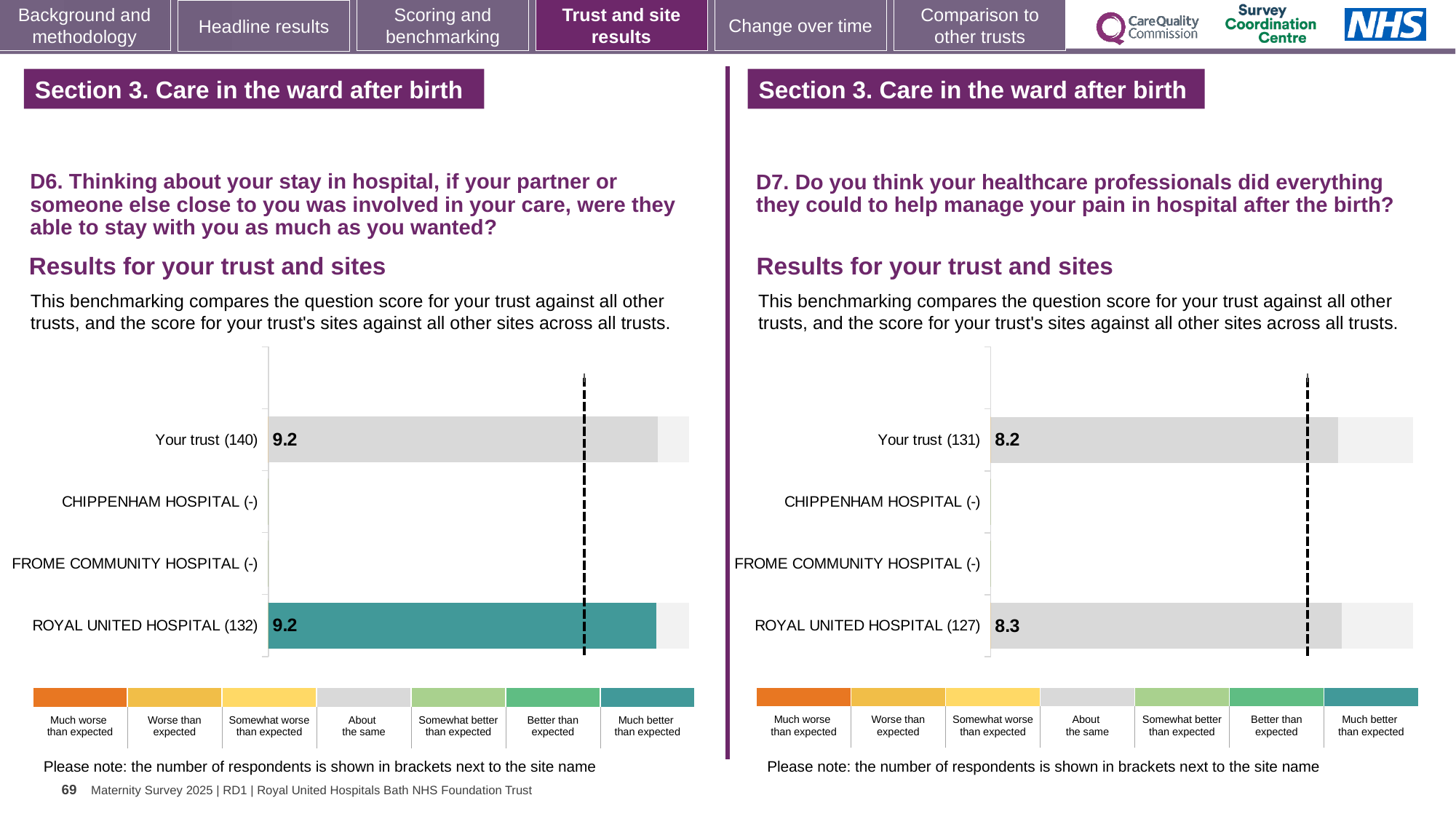
In the D6 chart on the left, what is the score for ROYAL UNITED HOSPITAL? 9.2 In the D6 chart on the left, how many respondents are shown in brackets for ROYAL UNITED HOSPITAL? 132 How many benchmark categories does the colour legend below the D6 chart on the left show? 7 In the D7 chart on the right, what is the difference between the scores for ROYAL UNITED HOSPITAL and Your trust? 0.1 In the D7 chart on the right, what is the score for ROYAL UNITED HOSPITAL? 8.3 What kind of chart is the D7 chart on the right? Bar chart In the D6 chart on the left, which benchmark category does the colour of the ROYAL UNITED HOSPITAL bar correspond to? Much better than expected How many categories are listed on the y axis of the D6 chart on the left? 4 In the D6 chart on the left, what is the score for Your trust? 9.2 In the D7 chart on the right, how many respondents are shown in brackets for Your trust? 131 In the D7 chart on the right, which has the higher score, Your trust or ROYAL UNITED HOSPITAL? ROYAL UNITED HOSPITAL In the D7 chart on the right, what is the score for Your trust? 8.2